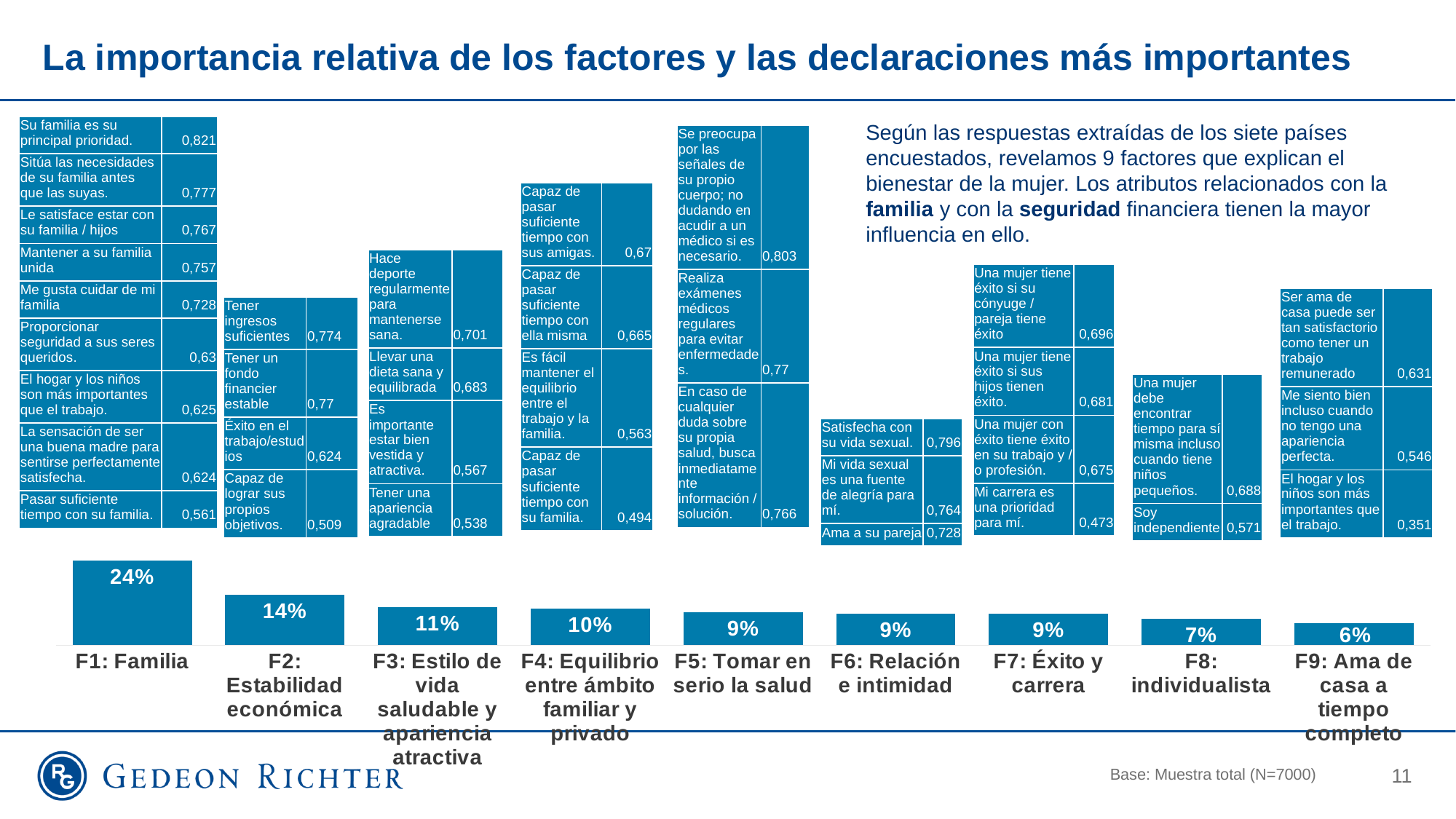
Which factor has the lowest percentage in the bar chart? F9: Ama de casa a tiempo completo What percentage is shown for F1: Familia in the bar chart? 24% What percentage is shown for F9: Ama de casa a tiempo completo? 6% What is the difference in percentage points between F1: Familia and F2: Estabilidad económica? 10 percentage points What kind of chart is used to show the factor percentages? Bar chart Which factor has the highest percentage in the bar chart? F1: Familia What value is shown for the statement 'Su familia es su principal prioridad.' under F1: Familia? 0,821 What percentage is shown for F2: Estabilidad económica? 14% Do the percentages rise or fall from F1 to F9 along the x axis? Fall What value is shown for the statement 'Satisfecha con su vida sexual.' under F6: Relación e intimidad? 0,796 Which has a higher percentage, F3: Estilo de vida saludable y apariencia atractiva or F8: individualista? F3: Estilo de vida saludable y apariencia atractiva How many factors are shown in the bar chart? 9